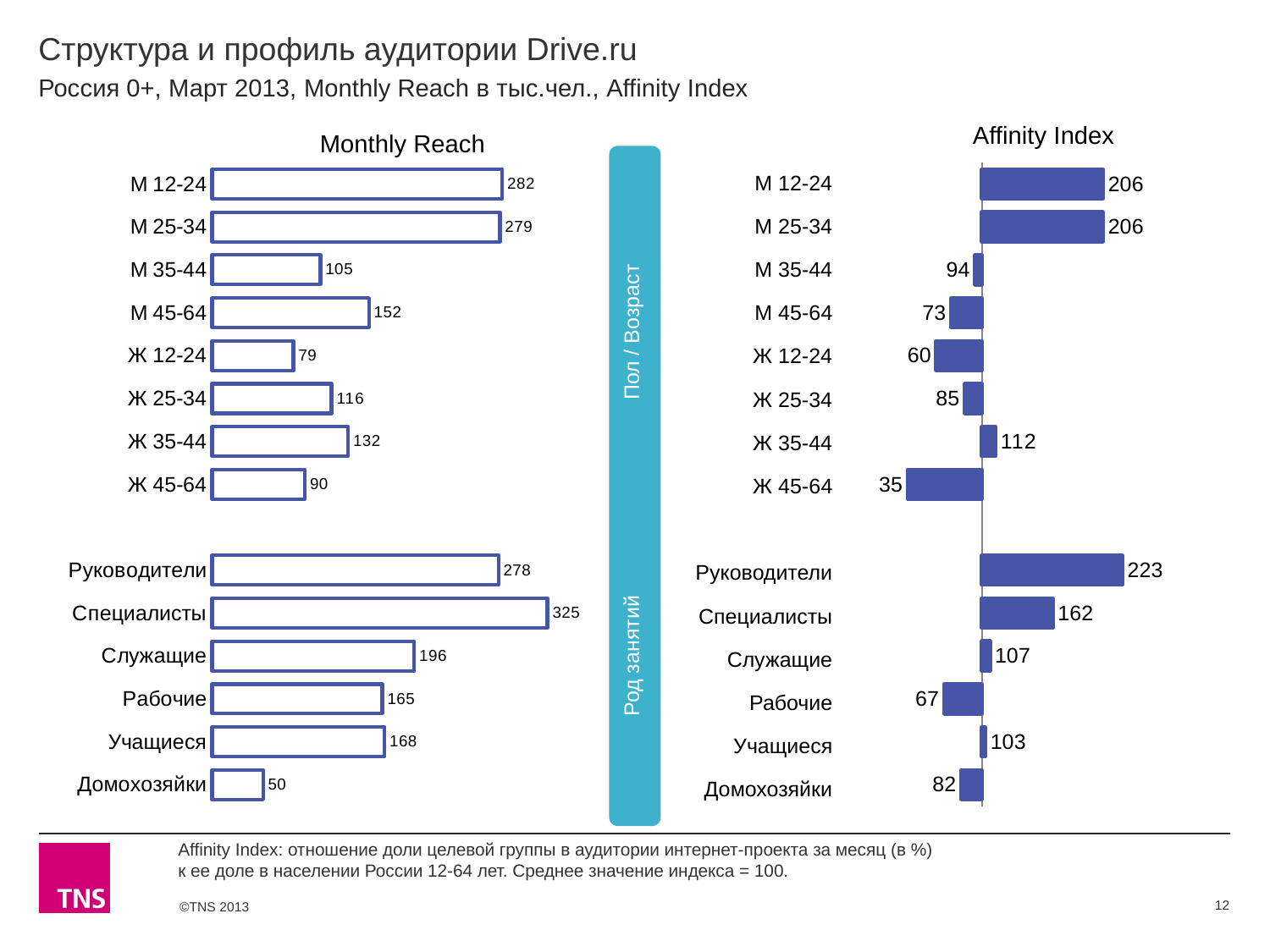
In the Affinity Index chart, which is larger: Служащие or Рабочие? Служащие In the Affinity Index chart, which category has the highest value? Руководители How many categories are plotted in the Monthly Reach chart? 14 In the Monthly Reach chart, which category has the lowest value? Домохозяйки In the Affinity Index chart, which category has the lowest value? Ж 45-64 In the Monthly Reach chart, what is the value for М 12-24? 282 In the Affinity Index chart, what is the difference between М 12-24 and М 35-44? 112 In the Affinity Index chart, what is the value for Руководители? 223 What type of chart is the Affinity Index chart? Bar chart In the Monthly Reach chart, which is larger: Ж 35-44 or Ж 25-34? Ж 35-44 In the Monthly Reach chart, what is the difference between Руководители and Служащие? 82 In the Monthly Reach chart, which category has the highest value? Специалисты